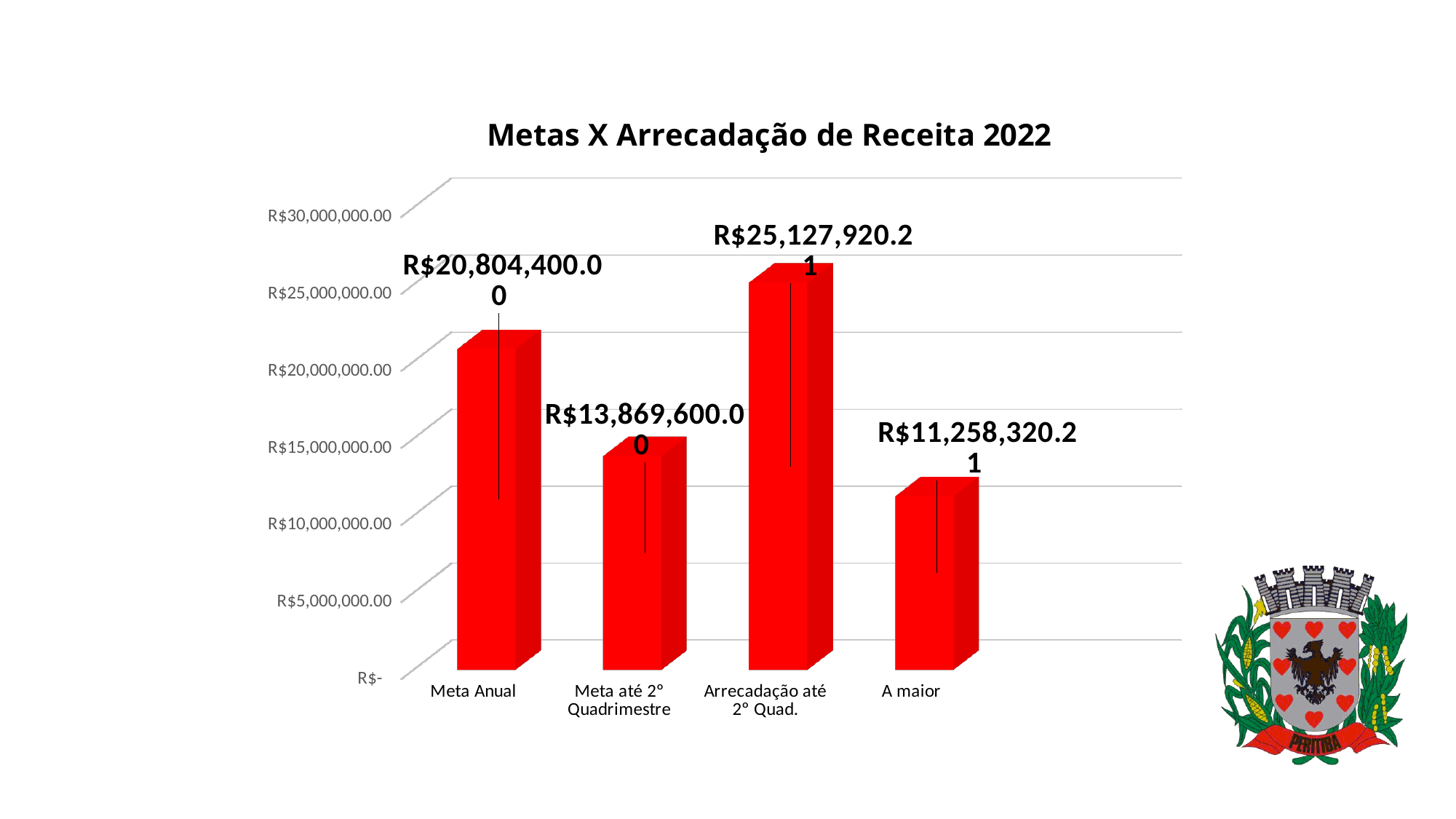
How many categories are shown on the chart? 4 Which category has the highest value? Arrecadação até 2° Quad. Which category has the lowest value? A maior What is the value for A maior? R$11,258,320.21 What is the title of the chart? Metas X Arrecadação de Receita 2022 Is the value for A maior greater or less than R$15,000,000.00? less Which is larger, Meta Anual or Arrecadação até 2° Quad.? Arrecadação até 2° Quad. What is the value for Meta até 2° Quadrimestre? R$13,869,600.00 What is the difference between Arrecadação até 2° Quad. and Meta até 2° Quadrimestre? R$11,258,320.21 What is the value for Arrecadação até 2° Quad.? R$25,127,920.21 What is the value for Meta Anual? R$20,804,400.00 What is the difference between Meta Anual and Meta até 2° Quadrimestre? R$6,934,800.00